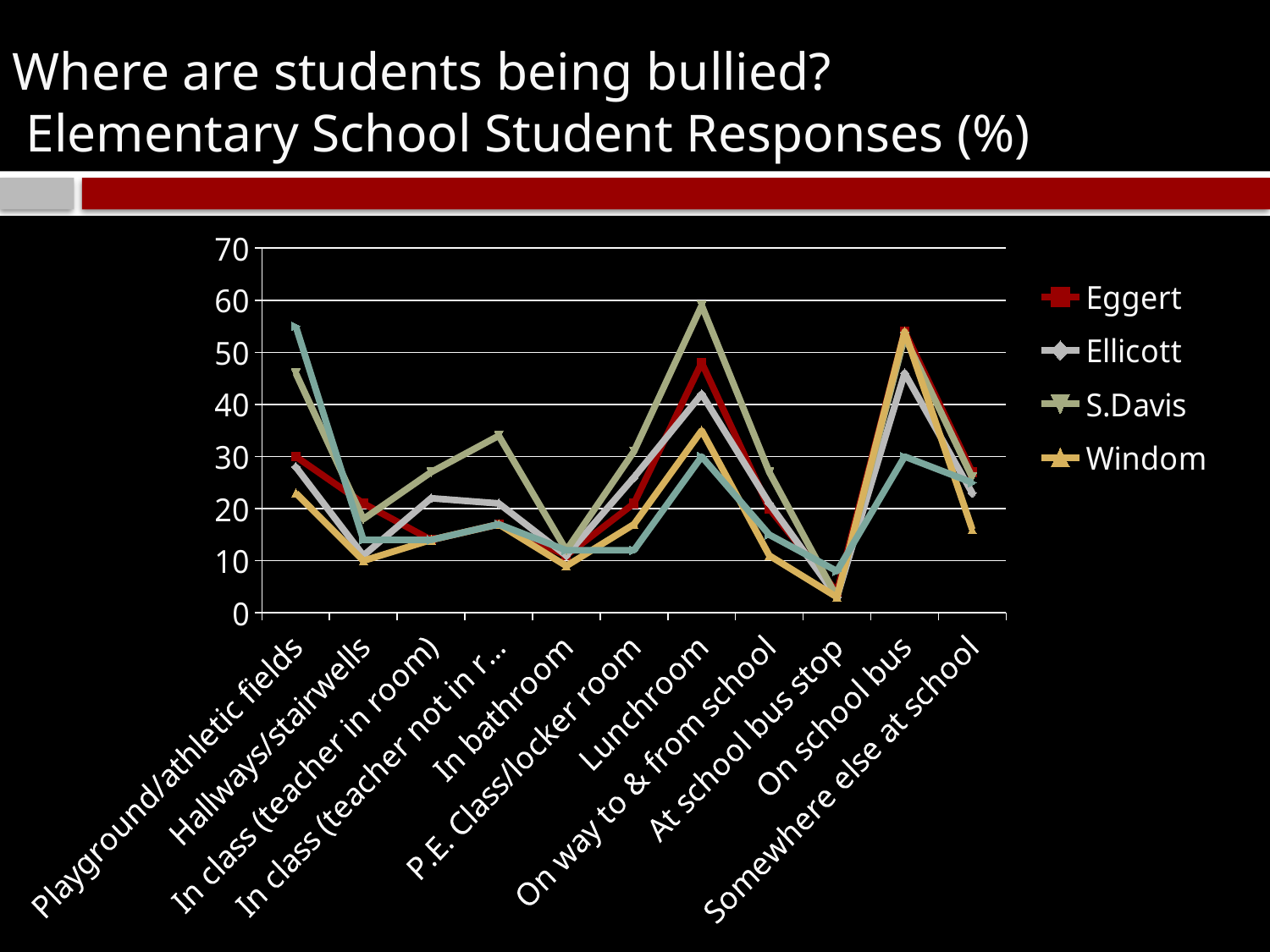
How many series does the legend list? 4 Is the Windom value for Somewhere else at school greater or less than 20? less For which category is the Windom value highest? On school bus Is the Windom value for At school bus stop greater or less than 10? less For which category is the Windom value lowest? At school bus stop For which category is the S.Davis value highest? Lunchroom What kind of chart is shown on the slide? line chart At Playground/athletic fields, which is larger: the S.Davis value or the Windom value? S.Davis Is the S.Davis value for Lunchroom greater or less than 50? greater At Lunchroom, which is larger: the S.Davis value or the Eggert value? S.Davis How many location categories are shown on the x axis? 11